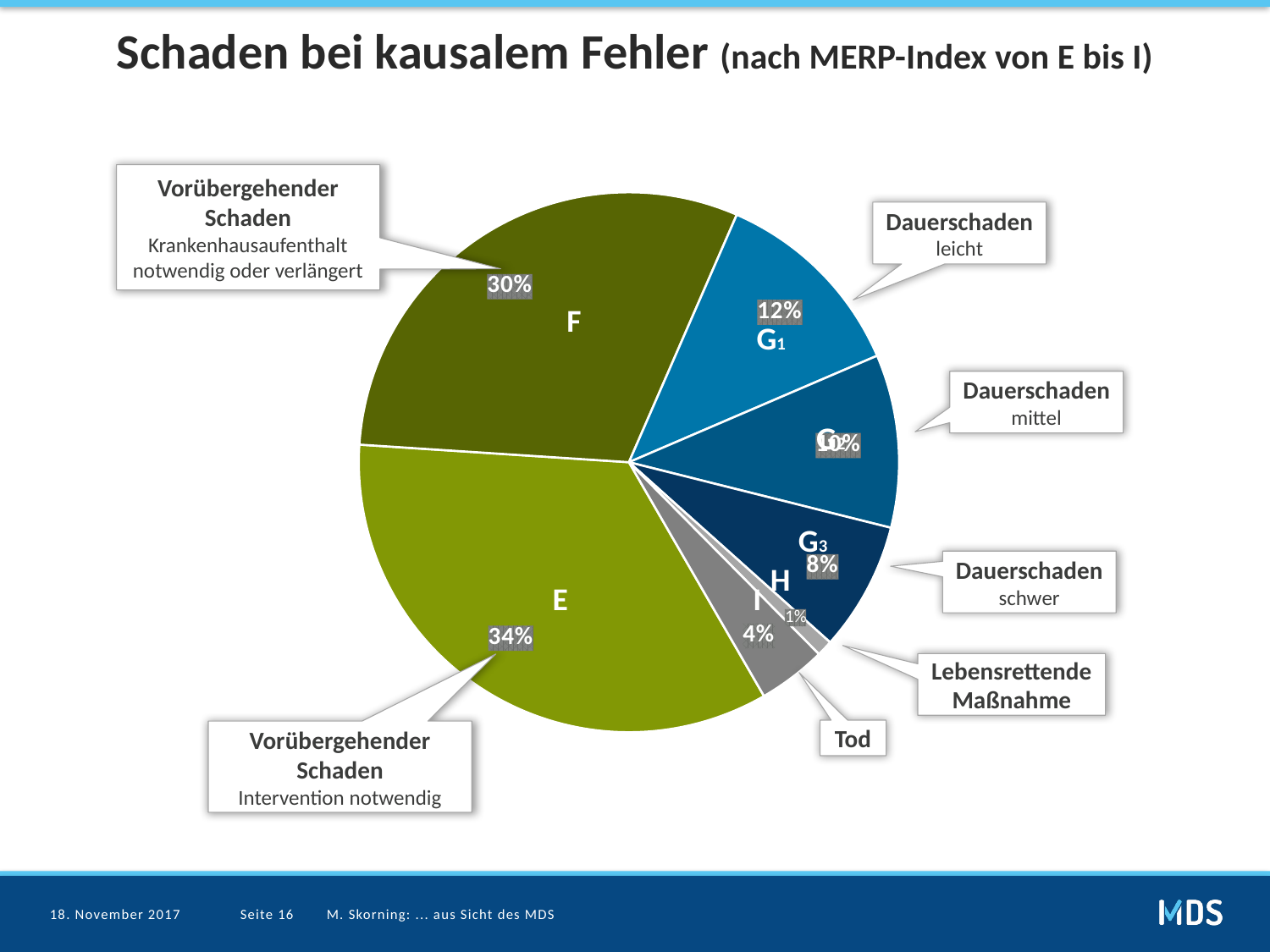
Which slice is labelled with the callout "Tod"? I Which slice has the largest share of the pie? E What percentage is shown for slice F? 30% What percentage is shown for slice H? 1% Which slice has the smallest share of the pie? H What percentage is shown for slice G1? 12% What kind of chart is shown on the slide? pie chart What percentage is shown for slice I? 4% What is the difference in percentage points between slice E and slice F? 4% What percentage is shown for slice E? 34% What percentage is shown for slice G3? 8% Which slice is larger, G1 or G3? G1